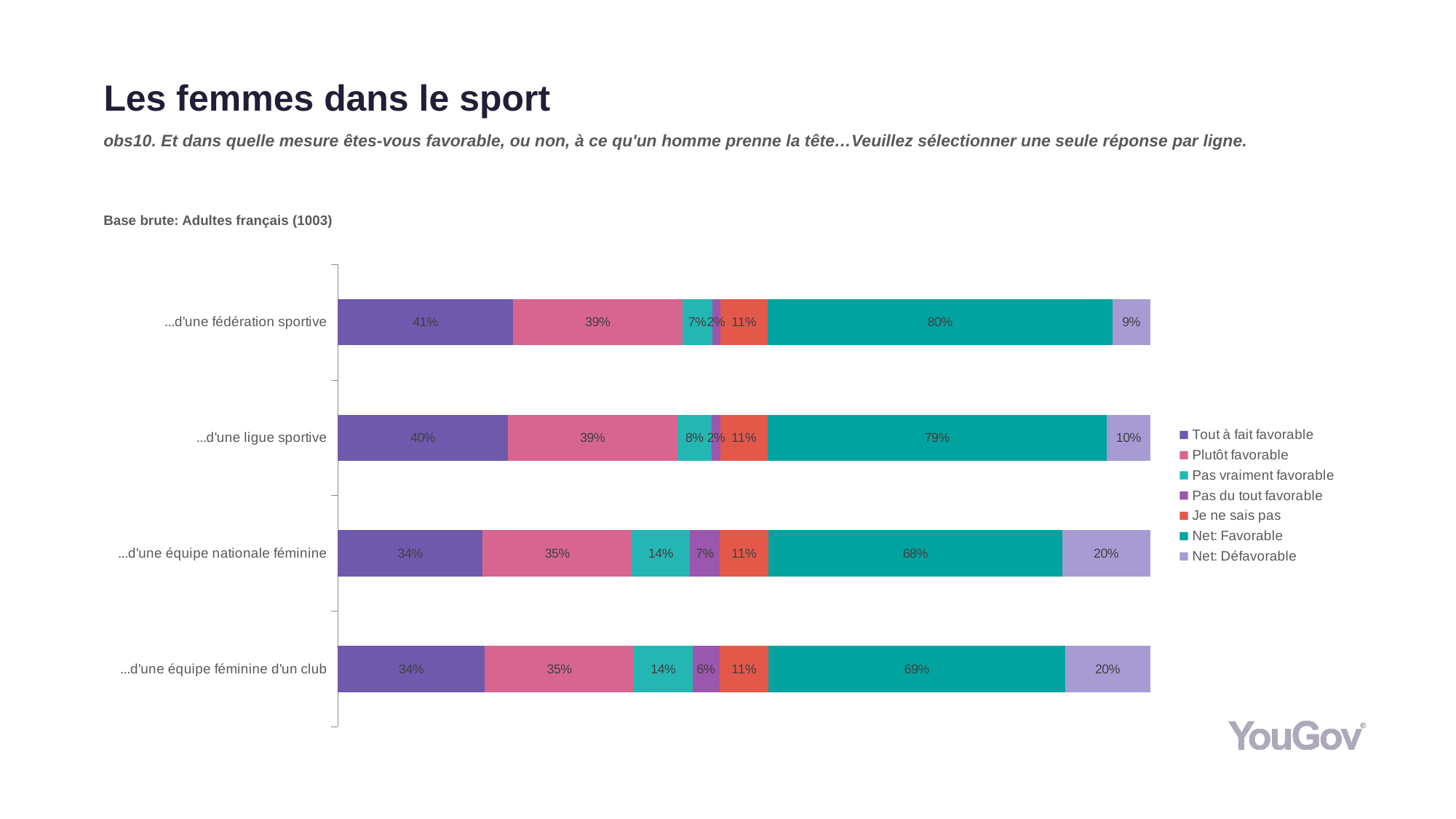
What is the difference between the 'Net: Favorable' values for '...d'une fédération sportive' and '...d'une équipe féminine d'un club'? 11% Which category has the lowest 'Net: Favorable' value? ...d'une équipe nationale féminine Which is larger: the 'Pas vraiment favorable' value for '...d'une ligue sportive' or for '...d'une équipe nationale féminine'? ...d'une équipe nationale féminine What kind of chart is shown on the slide? Stacked bar chart How many categories are shown on the chart? 4 What is the 'Net: Favorable' value for '...d'une équipe nationale féminine'? 68% What is the 'Je ne sais pas' value for '...d'une ligue sportive'? 11% What is the 'Tout à fait favorable' value for '...d'une fédération sportive'? 41% Which category has the highest 'Net: Favorable' value? ...d'une fédération sportive What is the 'Net: Défavorable' value for '...d'une ligue sportive'? 10% What is the 'Pas du tout favorable' value for '...d'une équipe féminine d'un club'? 6% How many series does the legend list? 7